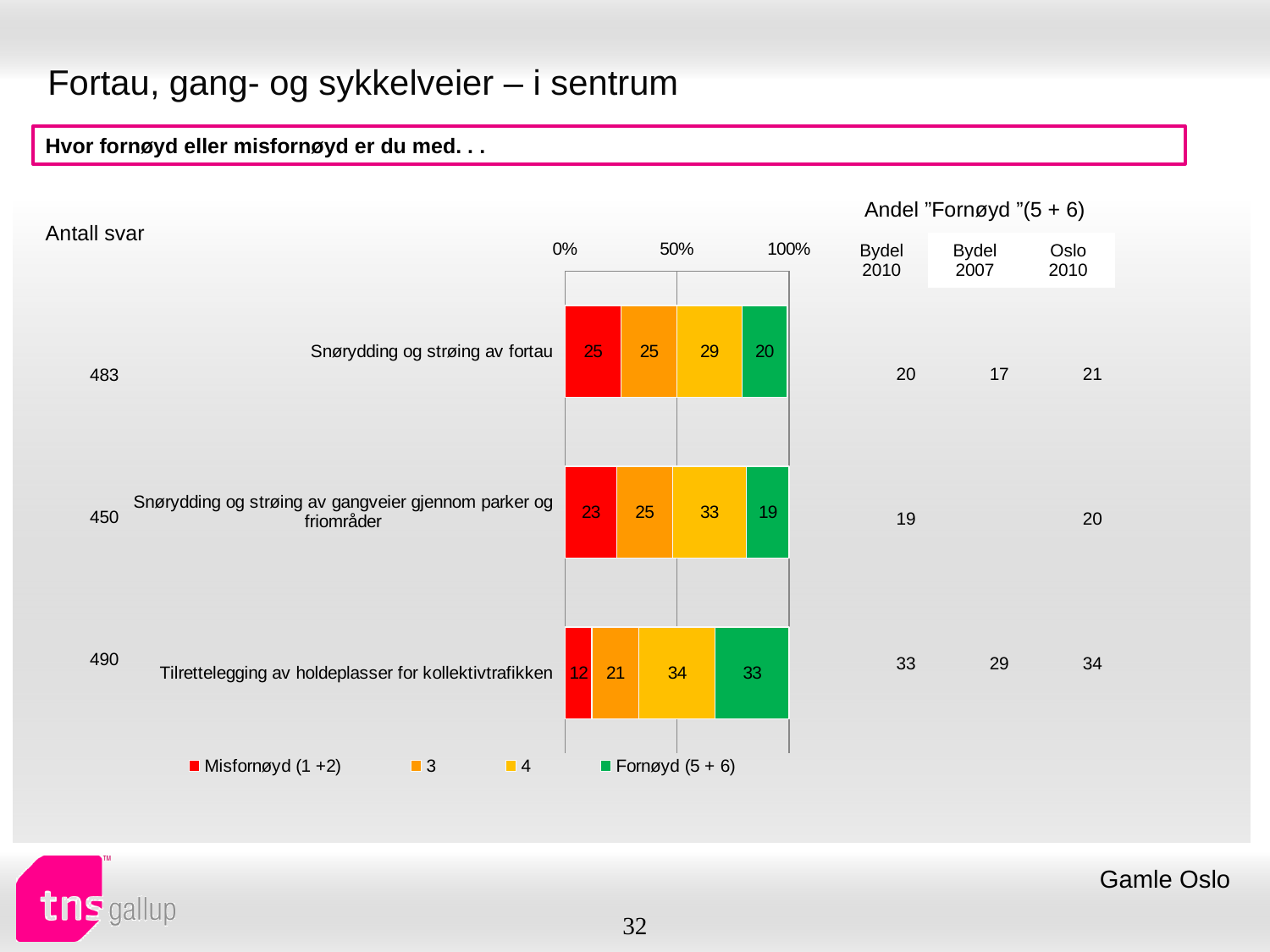
What is the difference between the "Fornøyd (5 + 6)" values for "Tilrettelegging av holdeplasser for kollektivtrafikken" and "Snørydding og strøing av fortau"? 13 What is the value of the "Misfornøyd (1 +2)" segment for "Tilrettelegging av holdeplasser for kollektivtrafikken"? 12 What kind of chart is shown on the slide? Stacked bar chart What is the total of the stacked bar for "Snørydding og strøing av gangveier gjennom parker og friområder"? 100 Which category has the lowest "Misfornøyd (1 +2)" value? Tilrettelegging av holdeplasser for kollektivtrafikken Which category has the highest "Fornøyd (5 + 6)" value? Tilrettelegging av holdeplasser for kollektivtrafikken How many series does the chart legend list? 4 How many categories are plotted in the chart? 3 Which is larger: the "Misfornøyd (1 +2)" value for "Snørydding og strøing av fortau" or for "Snørydding og strøing av gangveier gjennom parker og friområder"? Snørydding og strøing av fortau What is the value of the "4" segment for "Snørydding og strøing av gangveier gjennom parker og friområder"? 33 What colour represents the "Fornøyd (5 + 6)" series in the chart? Green What is the value of the "Fornøyd (5 + 6)" segment for "Snørydding og strøing av fortau"? 20